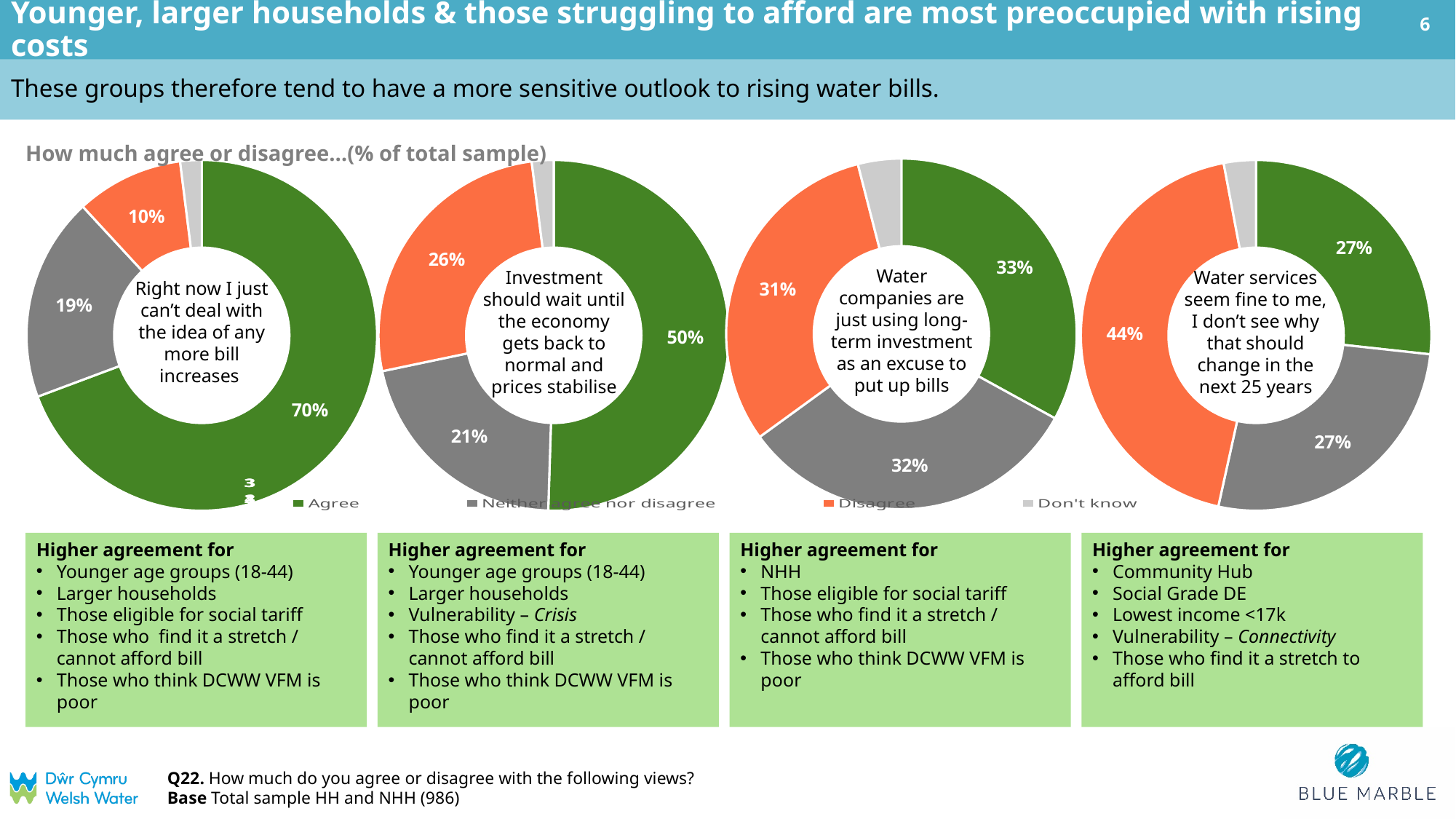
In the chart for 'Right now I just can't deal with the idea of any more bill increases', which is larger: Neither agree nor disagree or Disagree? Neither agree nor disagree In the chart for 'Investment should wait until the economy gets back to normal and prices stabilise', what percentage disagree? 26% In the chart for 'Investment should wait until the economy gets back to normal and prices stabilise', which is larger: Disagree or Neither agree nor disagree? Disagree Which colour represents 'Disagree' in the charts? Orange In the chart for 'Right now I just can't deal with the idea of any more bill increases', what percentage agree? 70% In the chart for 'Right now I just can't deal with the idea of any more bill increases', what is the difference between the Agree and Disagree percentages? 60% In the chart for 'Water services seem fine to me, I don't see why that should change in the next 25 years', what percentage disagree? 44% In the chart for 'Water companies are just using long-term investment as an excuse to put up bills', what percentage neither agree nor disagree? 32% In the chart for 'Water services seem fine to me, I don't see why that should change in the next 25 years', which response has the largest share? Disagree How many response categories does the legend list for the charts? 4 In the chart for 'Investment should wait until the economy gets back to normal and prices stabilise', what is the difference between the Agree and Neither agree nor disagree percentages? 29% What type of chart is used to show the responses on this slide? Donut (pie) chart